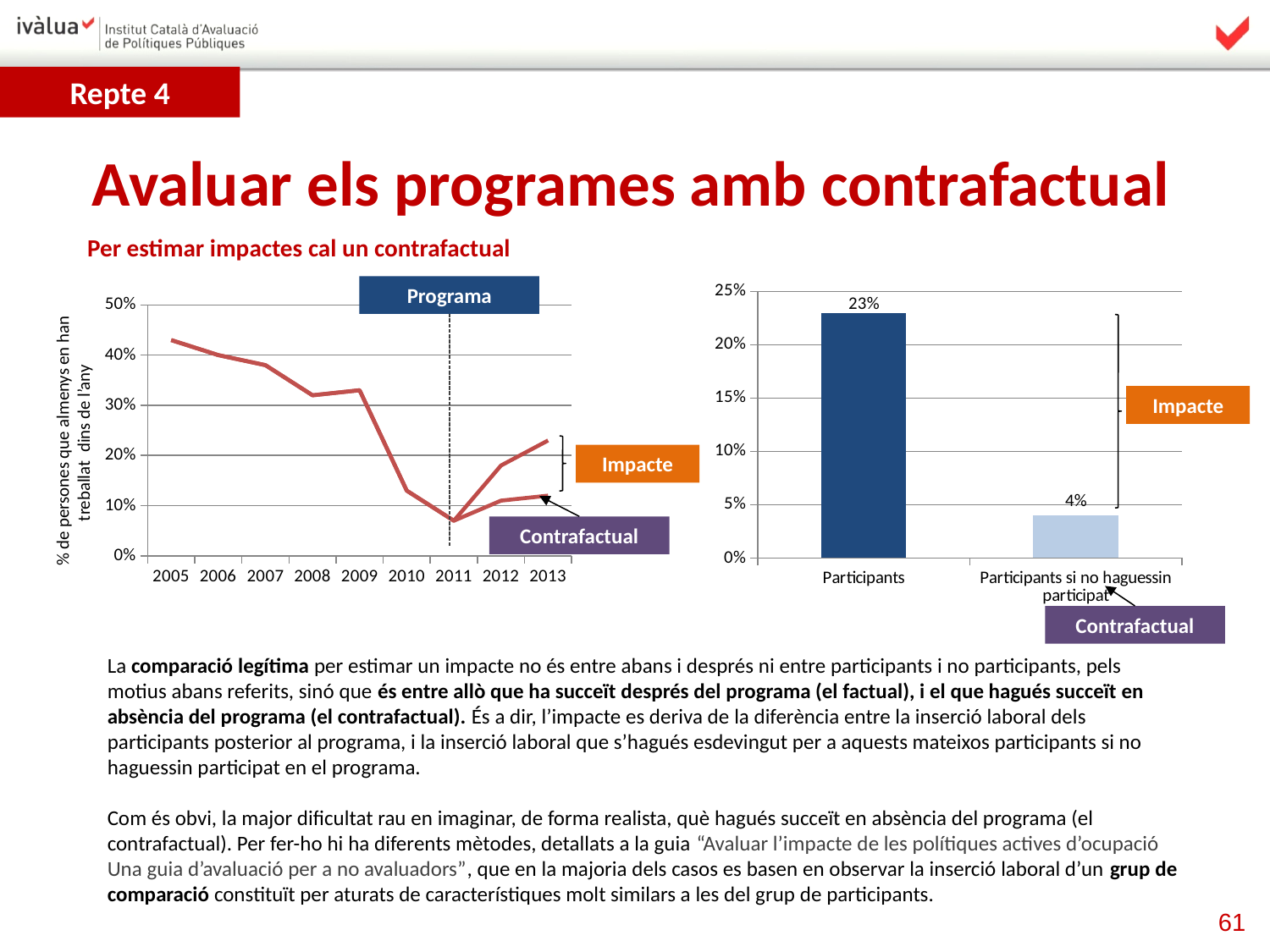
In the line chart on the left, is the value for 2005 greater or less than 40%? greater What kind of chart is the chart on the left? Line chart In the line chart on the left, how many years are shown on the x axis? 9 In the bar chart on the right, what is the value for 'Participants si no haguessin participat'? 4% In the bar chart on the right, which category has the highest value? Participants In the line chart on the left, is the value for 2011 greater or less than 10%? less In the bar chart on the right, what is the difference between the value for Participants and the value for 'Participants si no haguessin participat'? 19% What kind of chart is the chart on the right? Bar chart In the line chart on the left, what label is shown on the vertical dashed line? Programa In the bar chart on the right, how many categories are shown? 2 In the bar chart on the right, what is the value for Participants? 23% In the line chart on the left, do the values rise or fall from 2005 to 2011? fall